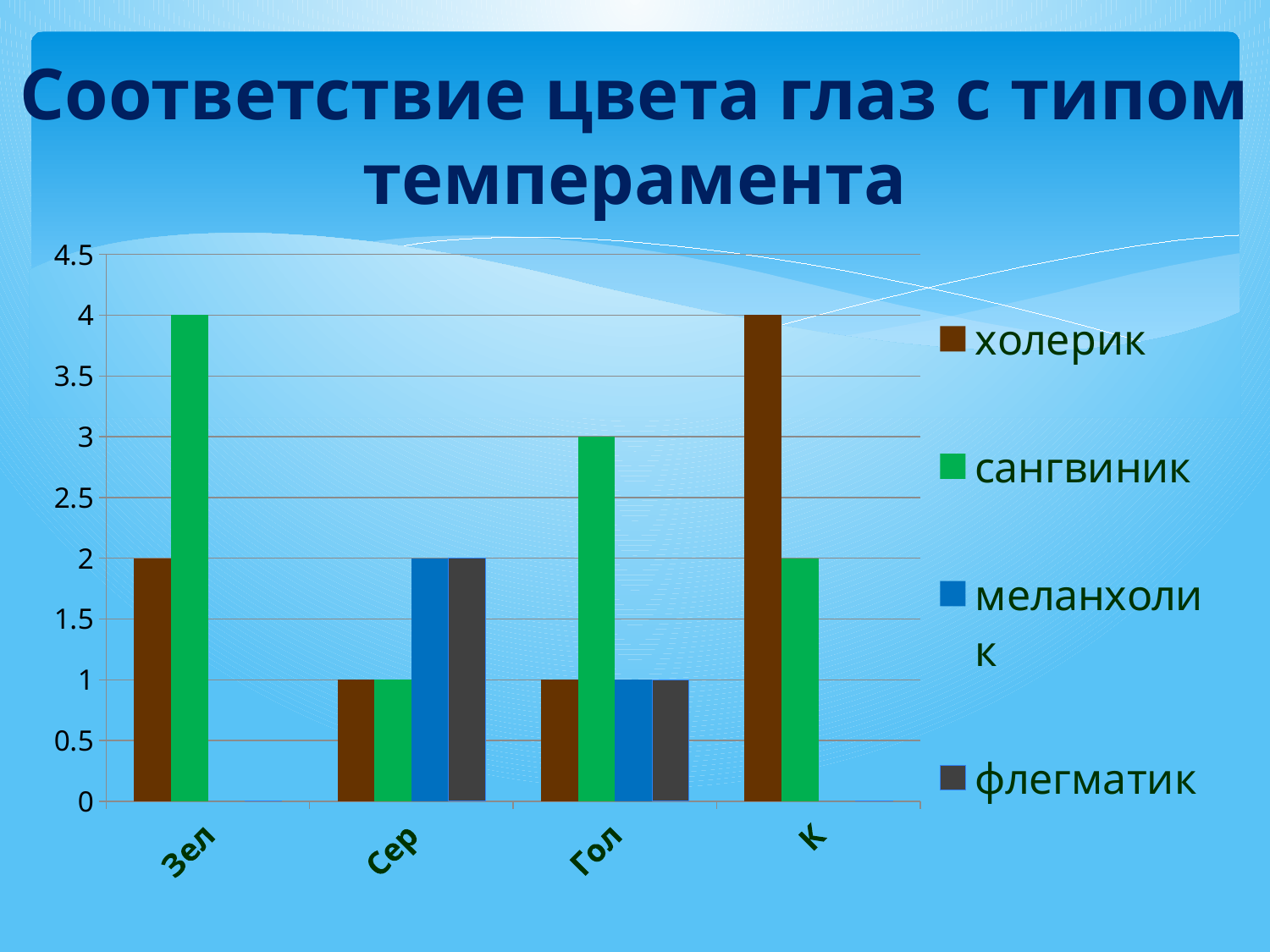
What is the value for сангвиник in the Зел category? 4 What is the value for флегматик in the Сер category? 2 Which category has the lowest value for сангвиник? Сер What is the title of the chart on the slide? Соответствие цвета глаз с типом темперамента What is the value for холерик in the К category? 4 What is the difference between the сангвиник value and the холерик value in the Зел category? 2 What is the value for сангвиник in the Гол category? 3 Which category has the highest value for холерик? К How many series does the legend list? 4 Which is larger in the Гол category: the value for сангвиник or the value for меланхолик? сангвиник What kind of chart is shown on the slide? bar chart How many categories are shown on the x axis? 4